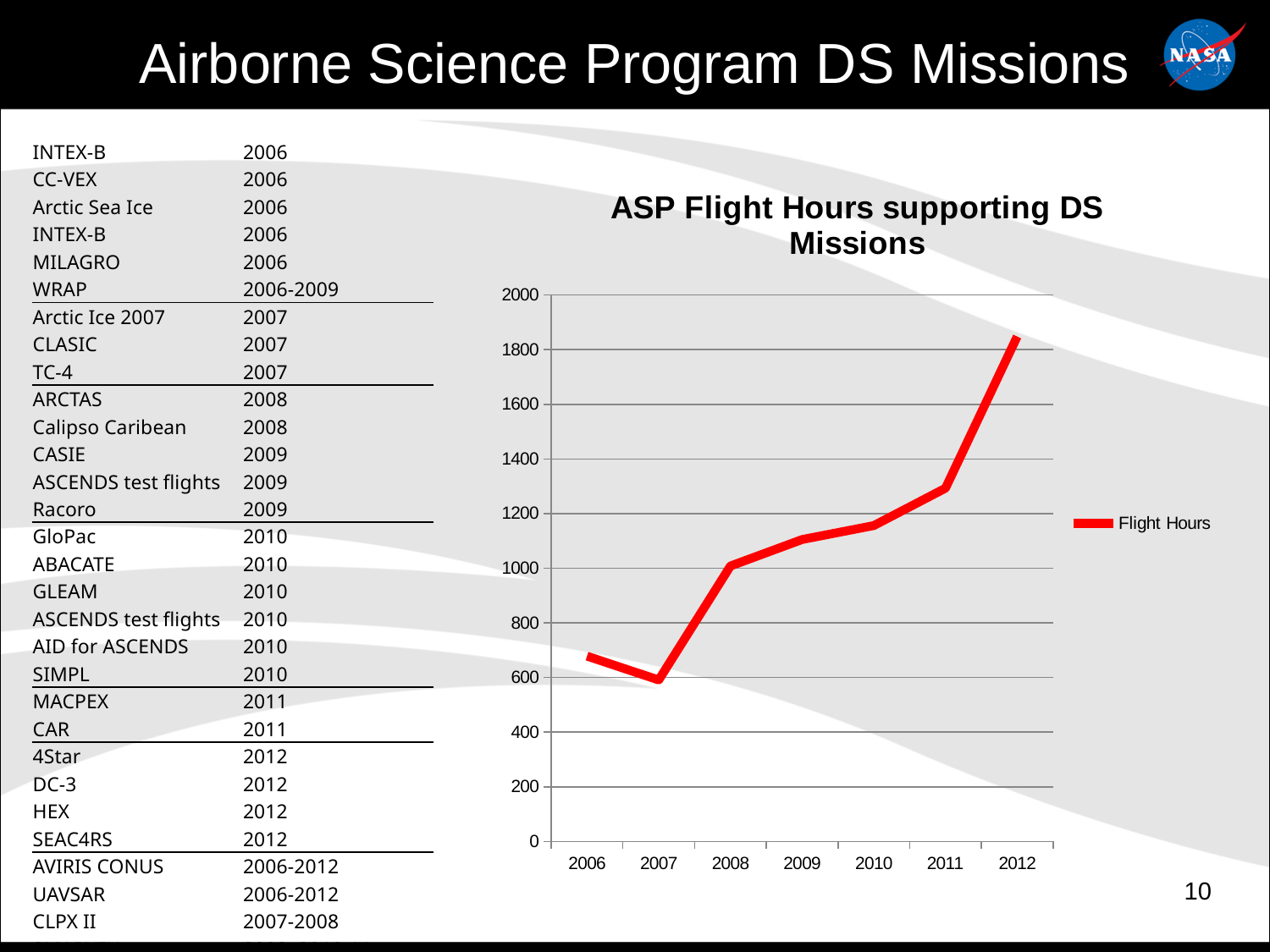
Is the value for 2012 greater or less than 1600? greater What is the name of the series shown in the legend? Flight Hours Which year has the lowest flight hours? 2007 Is the value for 2011 greater or less than 1200? greater How many years are plotted along the x axis? 7 What type of chart is shown on the slide? Line chart Is the value for 2006 greater or less than 600? greater Which year has more flight hours, 2007 or 2008? 2008 What is the title of the chart? ASP Flight Hours supporting DS Missions Which year has the highest flight hours? 2012 How many series does the chart legend list? 1